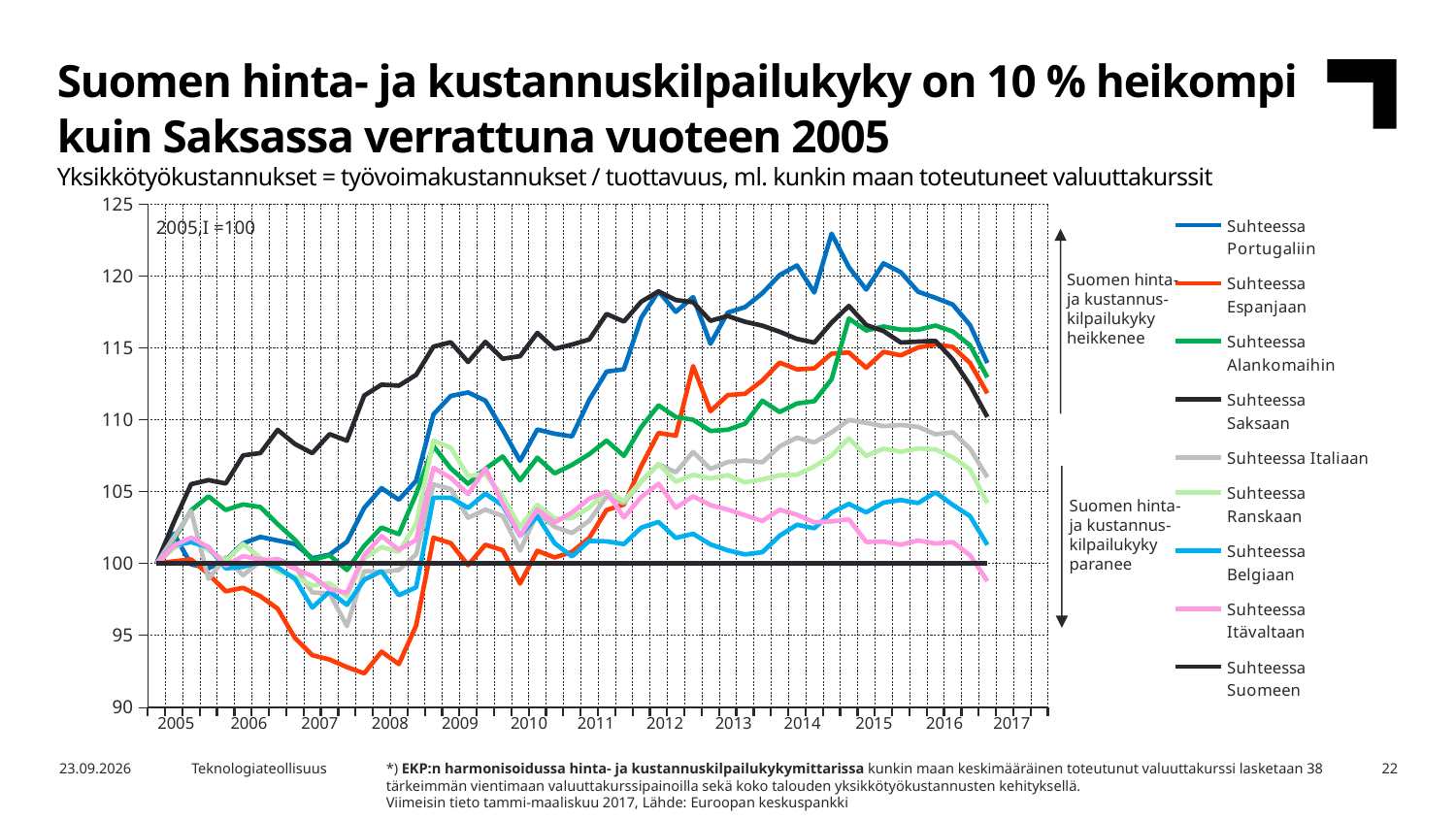
Is the lowest value of the Suhteessa Espanjaan line around 2007 greater or less than 95? less Is the value of the Suhteessa Saksaan line in 2012 greater or less than 115? greater What kind of chart is shown on the slide? line chart How many series does the legend list? 9 Which series reaches the lowest value anywhere on the chart? Suhteessa Espanjaan At what constant value does the Suhteessa Suomeen line stay throughout the chart? 100 Is the value of the Suhteessa Belgiaan line at the end of the series in 2017 greater or less than 105? less What base index is stated in the top-left corner of the chart? 2005,I = 100 In 2016, which is larger: the Suhteessa Portugaliin value or the Suhteessa Belgiaan value? Suhteessa Portugaliin Which series reaches the highest value anywhere on the chart? Suhteessa Portugaliin Does the Suhteessa Portugaliin line rise or fall between 2005 and 2014? rise